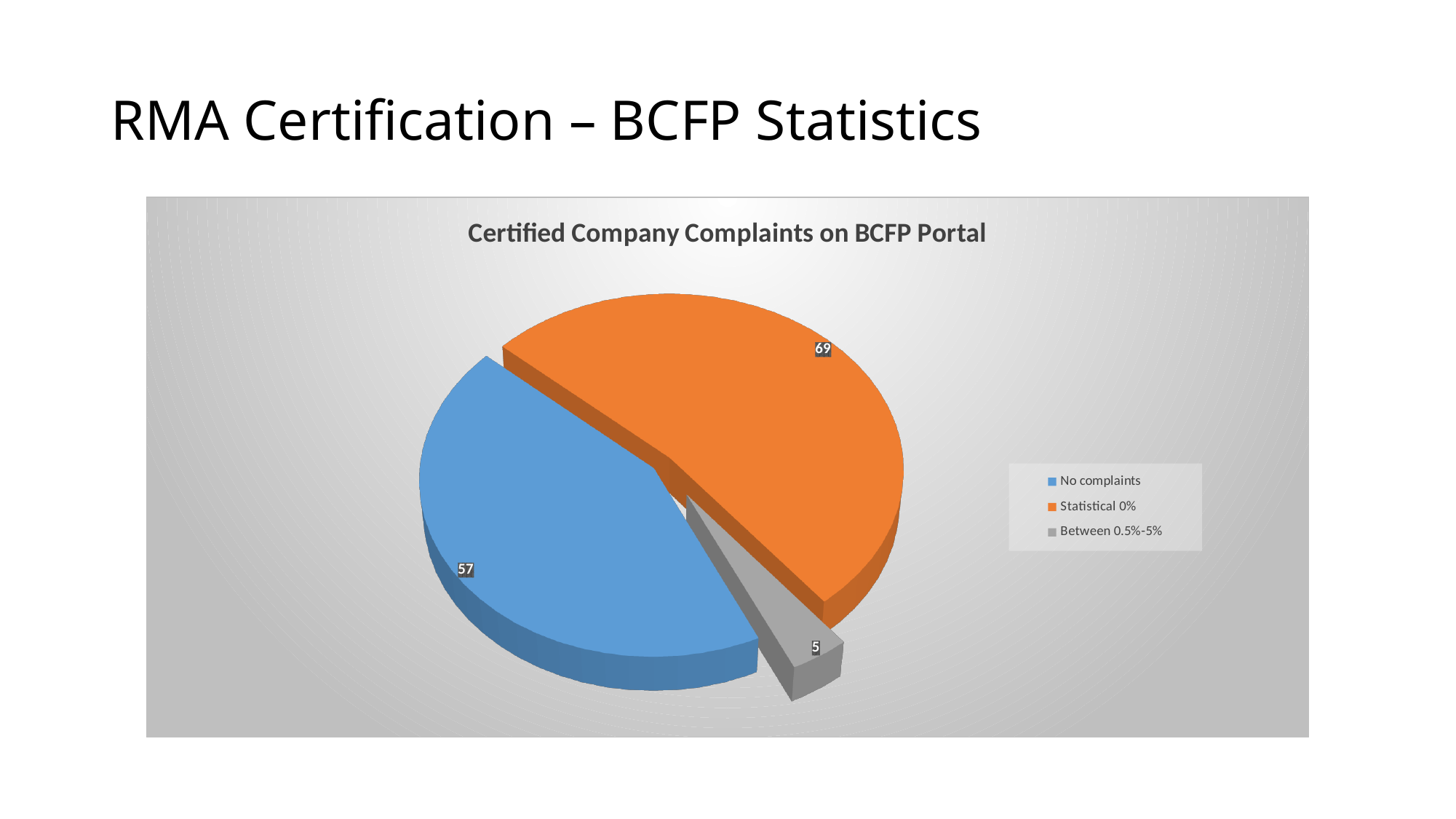
What is the value for No complaints? 57 Which category has the largest slice? Statistical 0% What is the total of all slices in the pie chart? 131 What is the value for Statistical 0%? 69 What is the title of the chart? Certified Company Complaints on BCFP Portal What kind of chart is shown on the slide? Pie chart What is the value for Between 0.5%-5%? 5 How many slices does the pie chart have? 3 What is the difference between the values for No complaints and Between 0.5%-5%? 52 What is the difference between the values for Statistical 0% and No complaints? 12 Which is larger, No complaints or Statistical 0%? Statistical 0% Which category has the smallest slice? Between 0.5%-5%